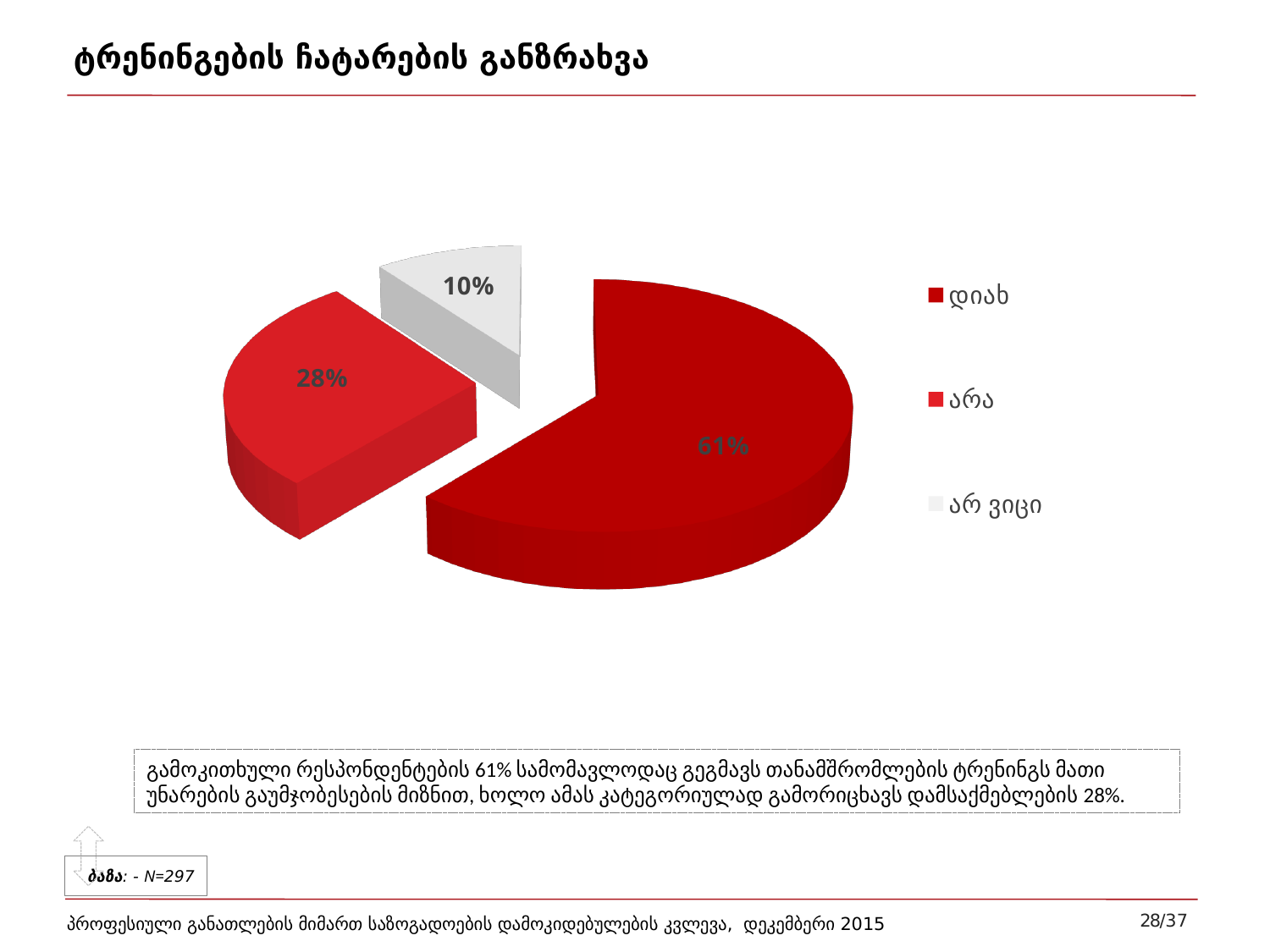
Which is larger, the slice for "არა" or the slice for "არ ვიცი"? არა How many slices does the pie chart have? 3 What is the difference in percentage points between "დიახ" and "არა"? 33 percentage points Which category has the smallest slice of the pie? არ ვიცი What is the value shown for "არა"? 28% What colour is the "არ ვიცი" slice in the pie chart? light grey Which category has the largest slice of the pie? დიახ What share of the pie does the "დიახ" slice represent? 61% What kind of chart is shown on the slide? pie chart How many entries does the legend list? 3 What is the title of the slide containing the chart? ტრენინგების ჩატარების განზრახვა What is the value shown for "არ ვიცი"? 10%